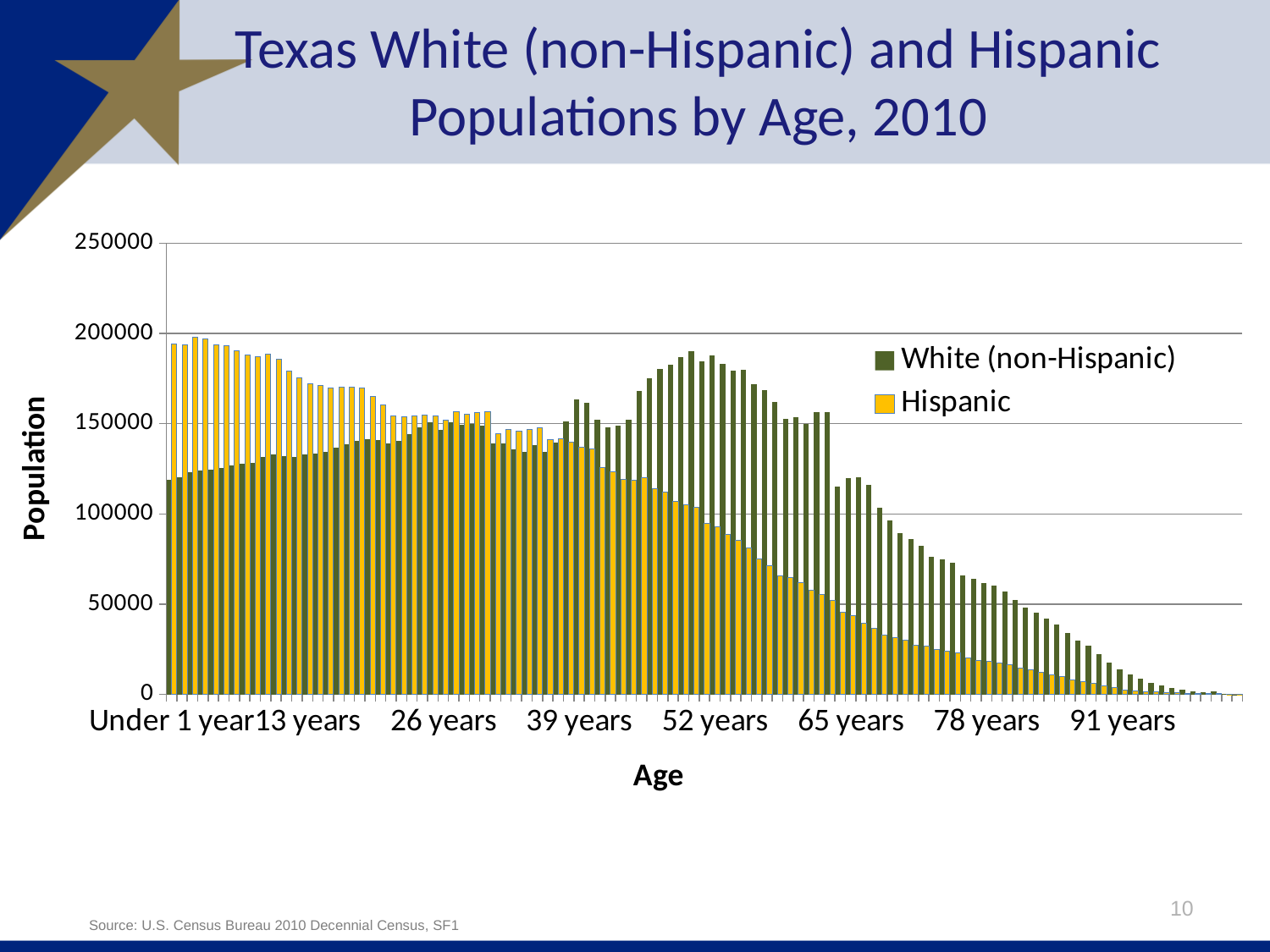
At 52 years, which series has the larger value, White (non-Hispanic) or Hispanic? White (non-Hispanic) At Under 1 year, which series has the larger value, White (non-Hispanic) or Hispanic? Hispanic Is the White (non-Hispanic) value for Under 1 year greater or less than 150000? less Do the Hispanic values rise or fall from 52 years to 91 years? fall How many series does the legend list? 2 Is the White (non-Hispanic) value for 78 years greater or less than 50000? greater What is the title of the vertical axis? Population Is the White (non-Hispanic) value for 52 years greater or less than 150000? greater What kind of chart is shown on the slide? Bar chart What are the two series named in the legend? White (non-Hispanic) and Hispanic